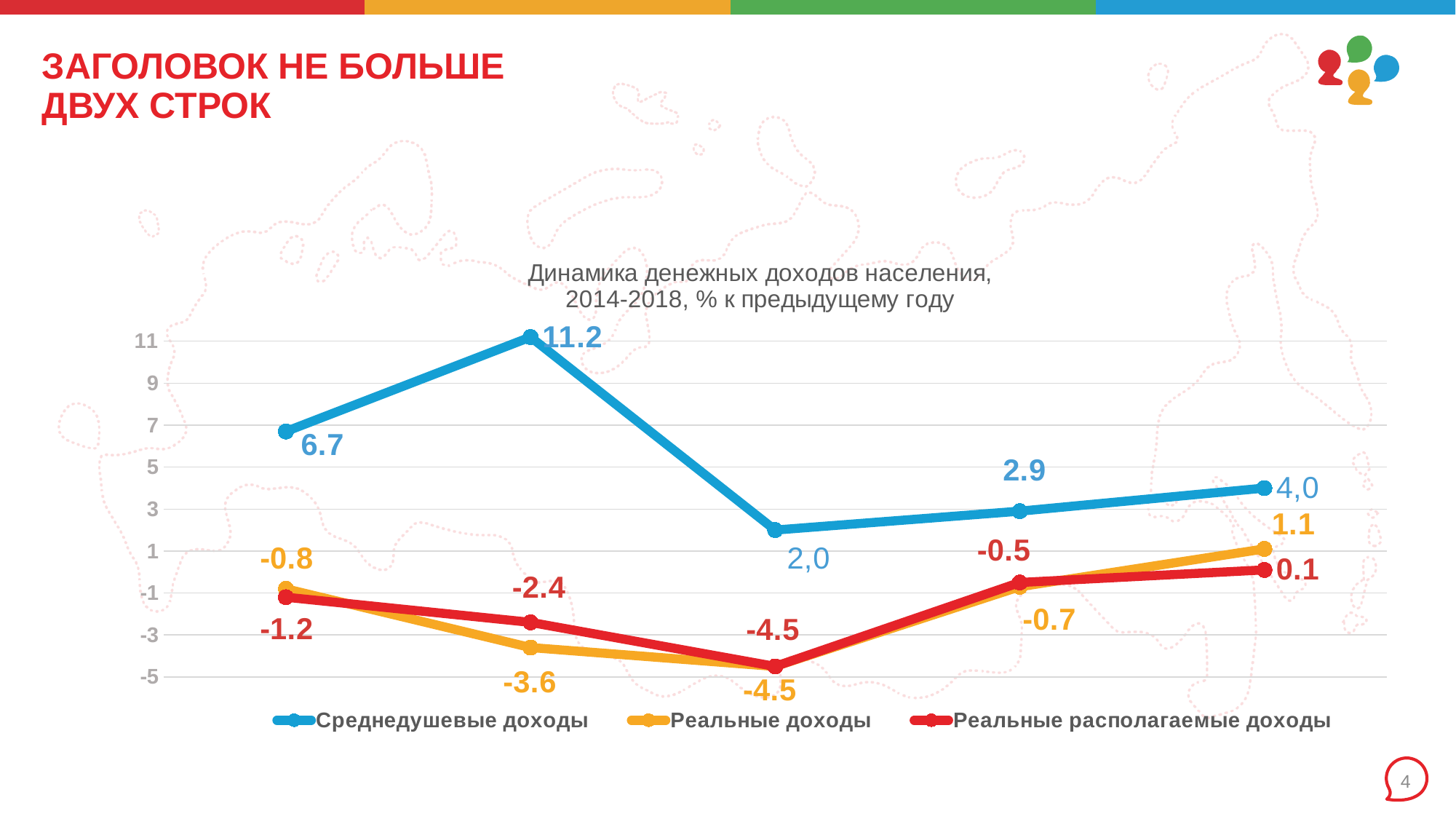
How many series does the legend list? 3 Do the values of the Реальные доходы line rise or fall from the third point to the last point? rise How many data points does the Среднедушевые доходы line have? 5 What is the highest value on the Среднедушевые доходы line? 11.2 What is the difference between the second point (11.2) and the first point (6.7) of the Среднедушевые доходы line? 4.5 At the second point, which is larger: Реальные доходы or Реальные располагаемые доходы? Реальные располагаемые доходы What is the value of the last point of the Среднедушевые доходы line? 4,0 What is the value of the first point of the Среднедушевые доходы line? 6.7 What kind of chart is shown on the slide? line chart What is the title of the chart? Динамика денежных доходов населения, 2014-2018, % к предыдущему году What is the value of the last point of the Реальные располагаемые доходы line? 0.1 What is the lowest value on the Реальные доходы line? -4.5